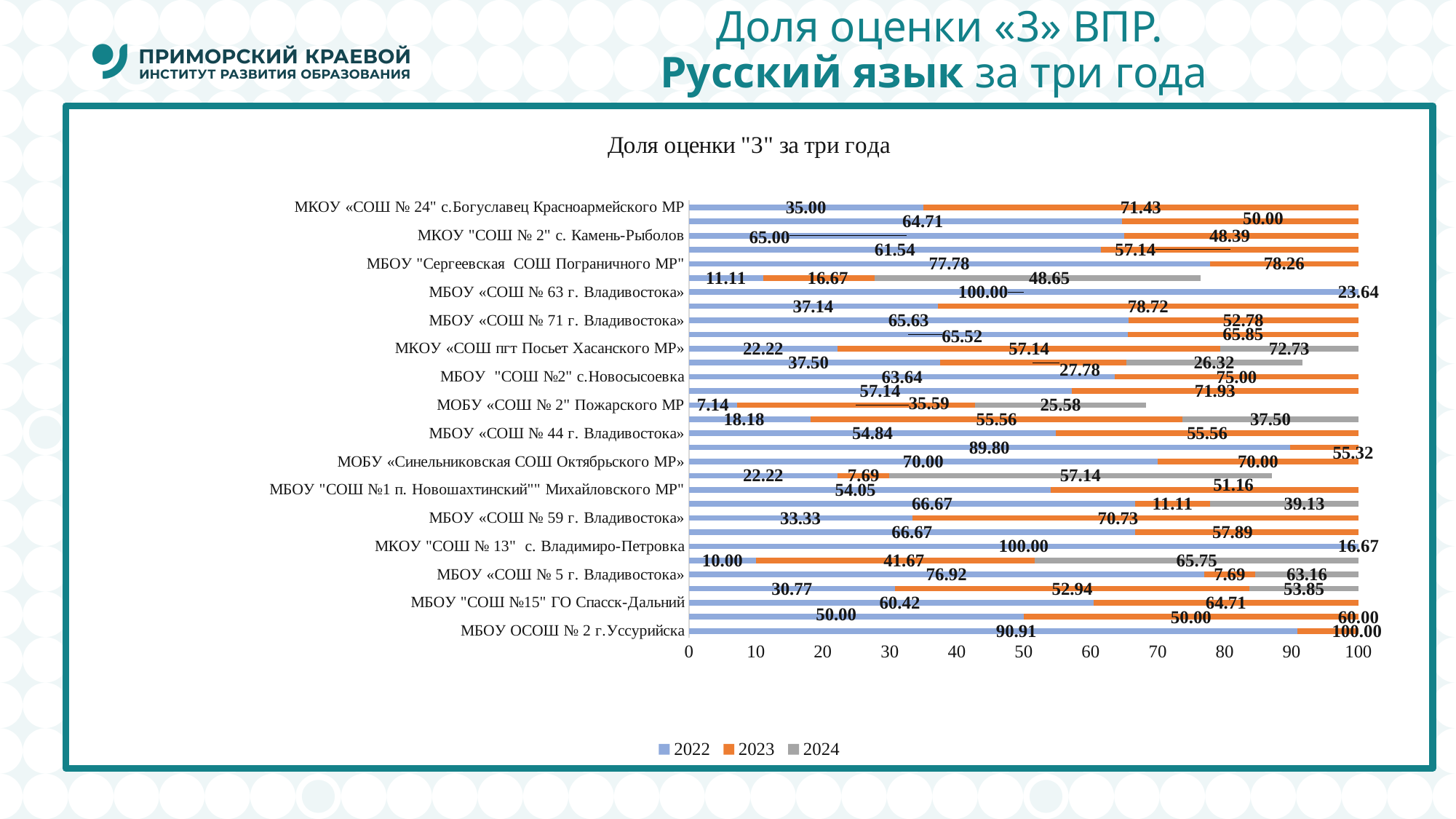
What kind of chart is shown on the slide? bar chart What is the title of the chart? Доля оценки "3" за три года What are the series names in the legend? 2022, 2023, 2024 What is the 2023 value for МКОУ "СОШ № 13" с. Владимиро-Петровка? 16.67 What is the 2022 value for МБОУ ОСОШ № 2 г.Уссурийска? 90.91 What is the difference between the 2023 and 2022 values for МБОУ ОСОШ № 2 г.Уссурийска? 9.09 What is the 2022 value for МКОУ "СОШ № 13" с. Владимиро-Петровка? 100.00 What is the 2023 value for МБОУ «СОШ № 63 г. Владивостока»? 23.64 What is the 2023 value for МБОУ ОСОШ № 2 г.Уссурийска? 100.00 What is the 2022 value for МБОУ «СОШ № 59 г. Владивостока»? 33.33 How many series does the legend list? 3 Which is larger for МКОУ "СОШ № 13" с. Владимиро-Петровка, the 2022 value or the 2023 value? 2022